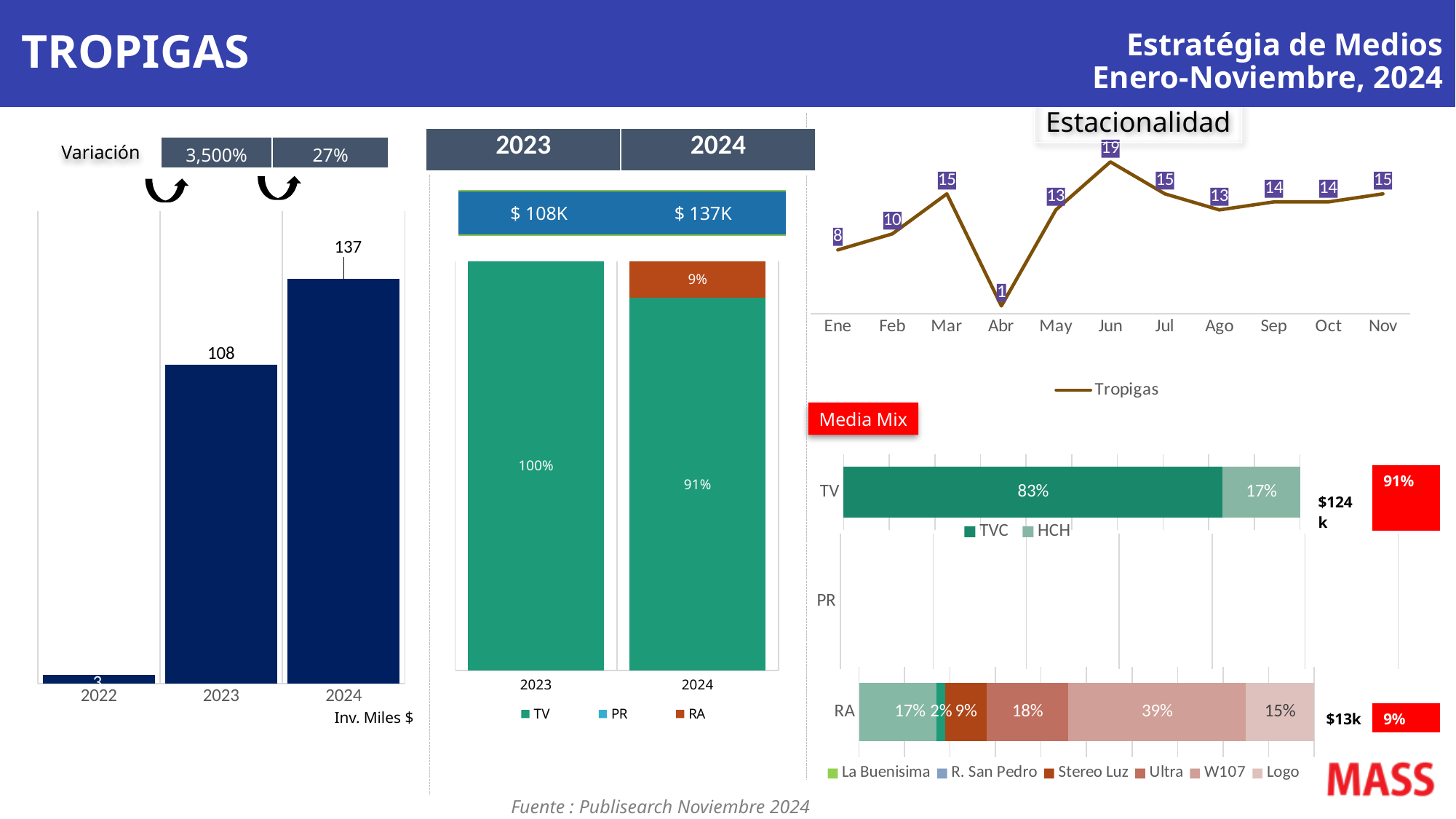
In the bar chart on the left (Inv. Miles $), what is the value for 2024? 137 In the middle stacked bar chart, what percentage does TV represent in 2023? 100% In the Estacionalidad line chart, which month has the highest value? Jun In the bar chart on the left (Inv. Miles $), how many years are shown? 3 In the Media Mix chart, what percentage of the TV bar is TVC? 83% In the bar chart on the left (Inv. Miles $), what is the value for 2023? 108 In the Estacionalidad line chart, what is the value for Abr? 1 In the middle stacked bar chart, how many series does the legend list? 3 In the bar chart on the left (Inv. Miles $), which year has the lowest value? 2022 In the bar chart on the left (Inv. Miles $), what is the difference between the 2024 and 2023 values? 29 In the middle stacked bar chart, what percentage does RA represent in 2024? 9% In the Estacionalidad line chart, what is the difference between the values for Jun and Ene? 11